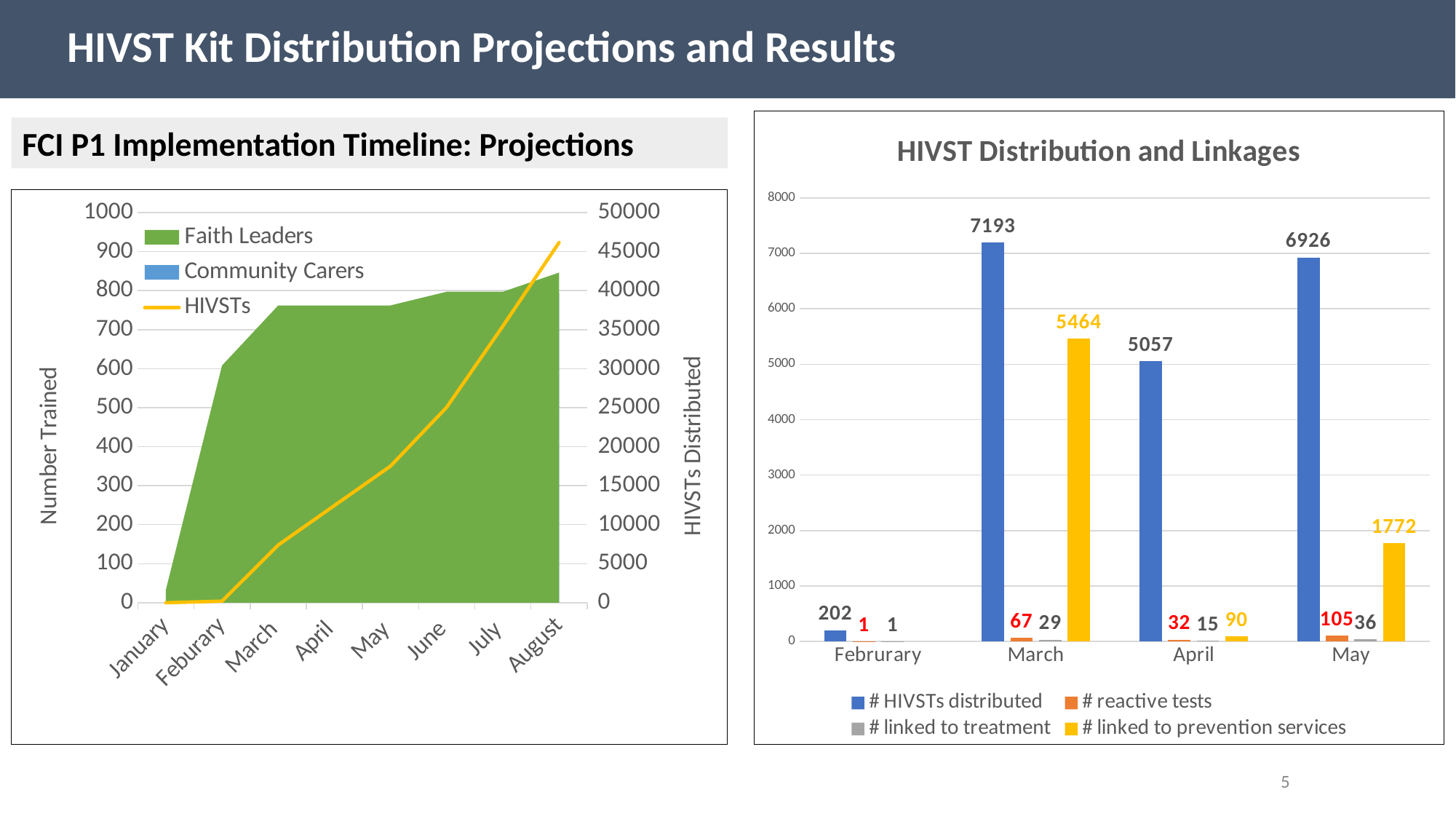
In the 'FCI P1 Implementation Timeline: Projections' chart, is the HIVSTs value for August greater or less than 40000? greater In the 'HIVST Distribution and Linkages' chart, how many reactive tests were there in April? 32 In the 'HIVST Distribution and Linkages' chart, which month has the lowest number of reactive tests? February In the 'HIVST Distribution and Linkages' chart, what is the number linked to prevention services in May? 1772 In the 'HIVST Distribution and Linkages' chart, how many series does the legend list? 4 In the 'HIVST Distribution and Linkages' chart, which is larger: the number linked to treatment in March or in May? May In the 'HIVST Distribution and Linkages' chart, how many HIVSTs were distributed in March? 7193 In the 'HIVST Distribution and Linkages' chart, what is the difference between the number of HIVSTs distributed in March and in May? 267 In the 'FCI P1 Implementation Timeline: Projections' chart, does the HIVSTs line rise or fall from January to August? Rise In the 'HIVST Distribution and Linkages' chart, which month has the highest number of HIVSTs distributed? March What kind of chart is the 'HIVST Distribution and Linkages' chart? Bar chart In the 'HIVST Distribution and Linkages' chart, how many months are shown on the x axis? 4